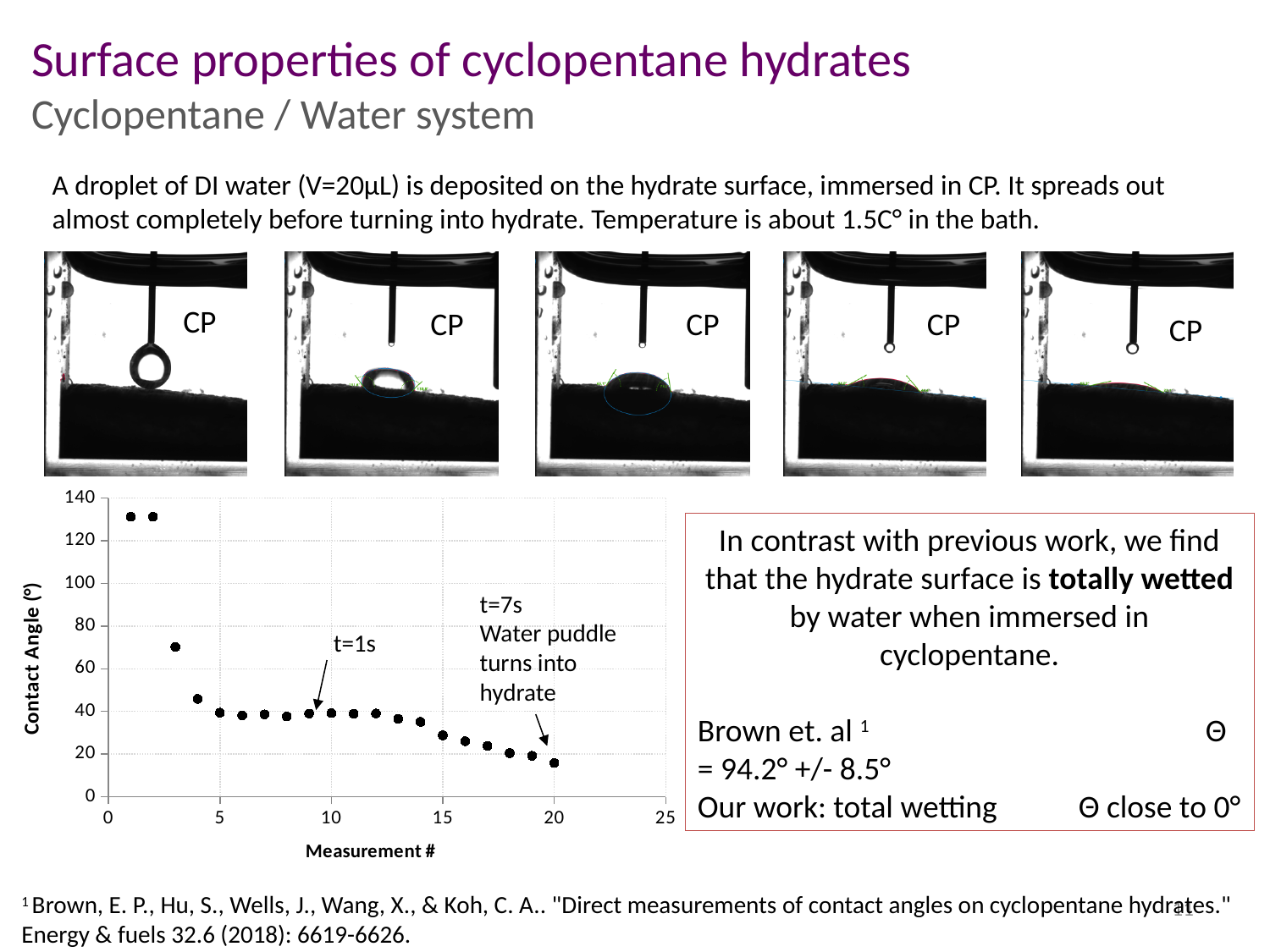
Is the contact angle for measurement 15 greater or less than 40? less Which has a larger contact angle, measurement 3 or measurement 4? measurement 3 Do the contact angle values generally rise or fall as the measurement number increases? fall Is the contact angle for measurement 3 greater or less than 80? less How many data points are plotted in the chart? 20 Which has a larger contact angle, measurement 2 or measurement 10? measurement 2 What is the label of the x axis of the chart? Measurement # What is the label of the y axis of the chart? Contact Angle (°) Is the contact angle for measurement 1 greater or less than 120? greater What kind of chart is shown on the slide? scatter chart